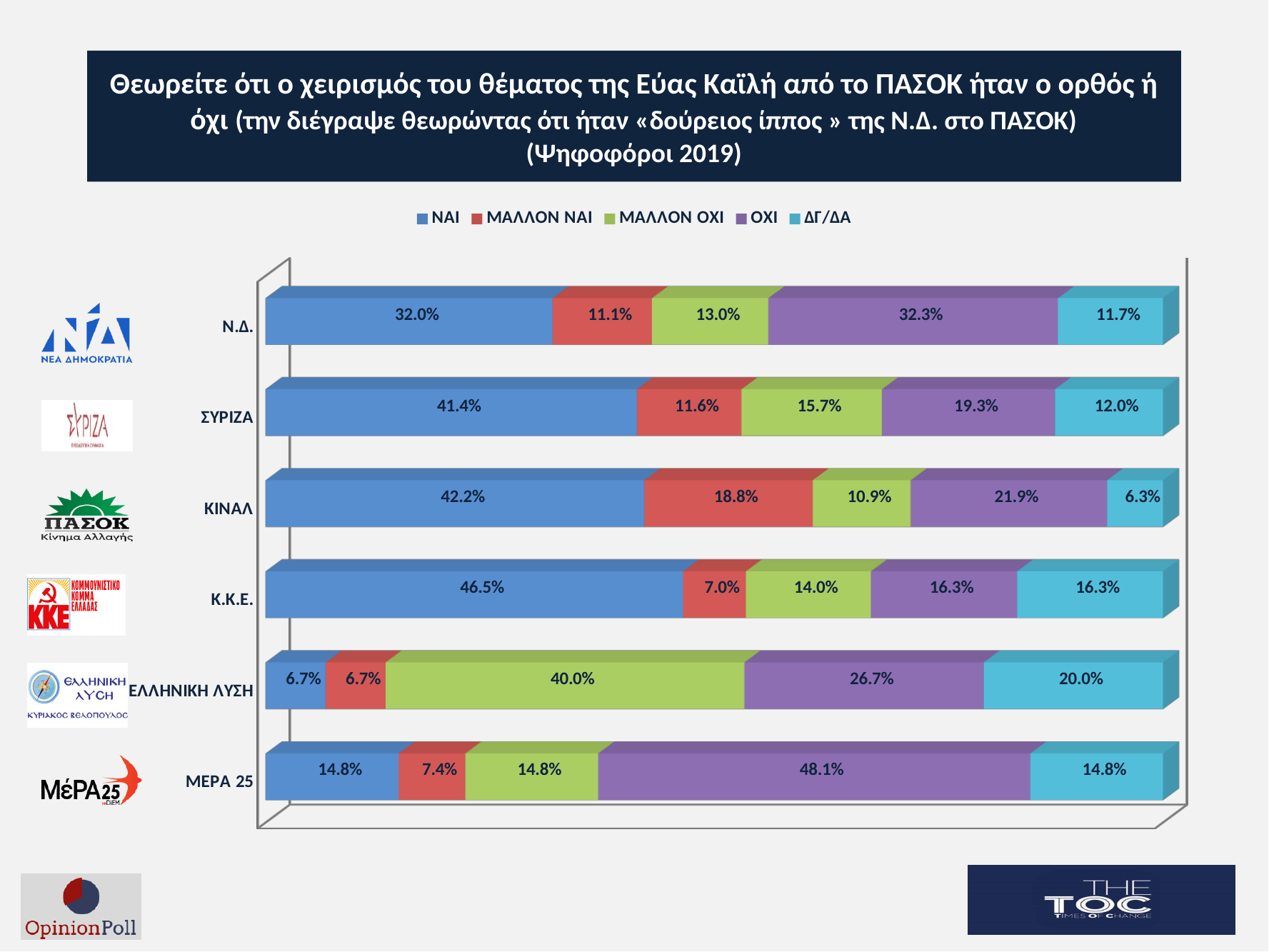
Which is larger: the ΜΑΛΛΟΝ ΝΑΙ value for ΚΙΝΑΛ or the ΜΑΛΛΟΝ ΝΑΙ value for ΣΥΡΙΖΑ? ΚΙΝΑΛ Which party has the lowest ΝΑΙ value? ΕΛΛΗΝΙΚΗ ΛΥΣΗ What is the ΜΑΛΛΟΝ ΟΧΙ value for ΕΛΛΗΝΙΚΗ ΛΥΣΗ? 40.0% What is the ΝΑΙ value for Κ.Κ.Ε.? 46.5% What is the ΟΧΙ value for ΜΕΡΑ 25? 48.1% How many series does the legend list? 5 What is the ΔΓ/ΔΑ value for ΚΙΝΑΛ? 6.3% How many parties are shown on the chart? 6 What kind of chart is shown on the slide? Stacked bar chart Which legend entry is shown in purple? ΟΧΙ What is the difference between the ΟΧΙ value for Ν.Δ. and the ΟΧΙ value for ΣΥΡΙΖΑ? 13.0% Which party has the highest ΝΑΙ value? Κ.Κ.Ε.